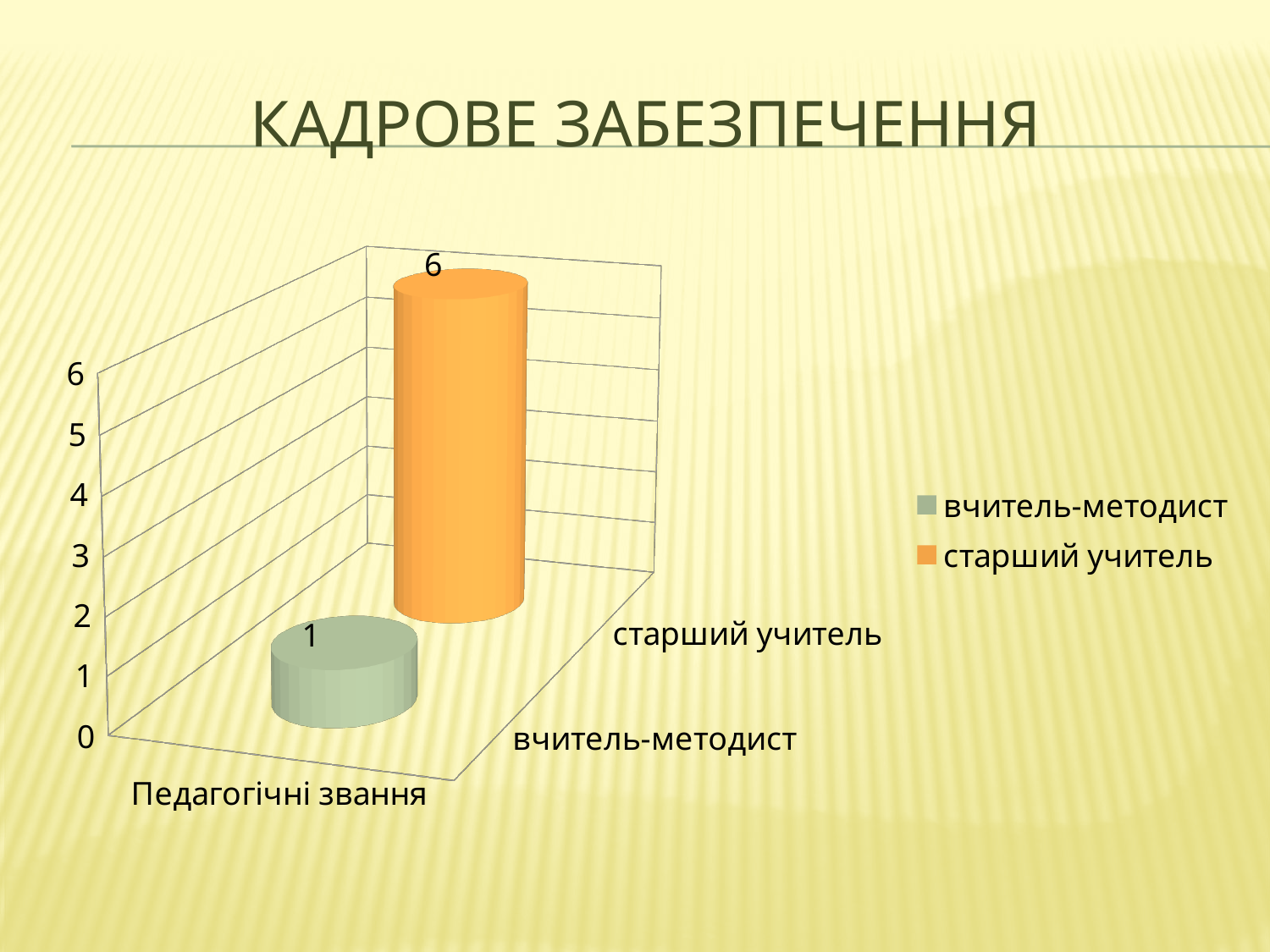
What is the title of the slide? КАДРОВЕ ЗАБЕЗПЕЧЕННЯ What is the category label shown on the x axis of the chart? Педагогічні звання How many series does the legend list? 2 What is the value for вчитель-методист? 1 Which series has the highest value? старший учитель Which is larger, the value for старший учитель or the value for вчитель-методист? старший учитель Which series has the lowest value? вчитель-методист Is the value for вчитель-методист greater or less than 2? less Is the value for старший учитель greater or less than 3? greater What kind of chart is shown on the slide? bar chart What is the difference between the values for старший учитель and вчитель-методист? 5 What is the value for старший учитель? 6